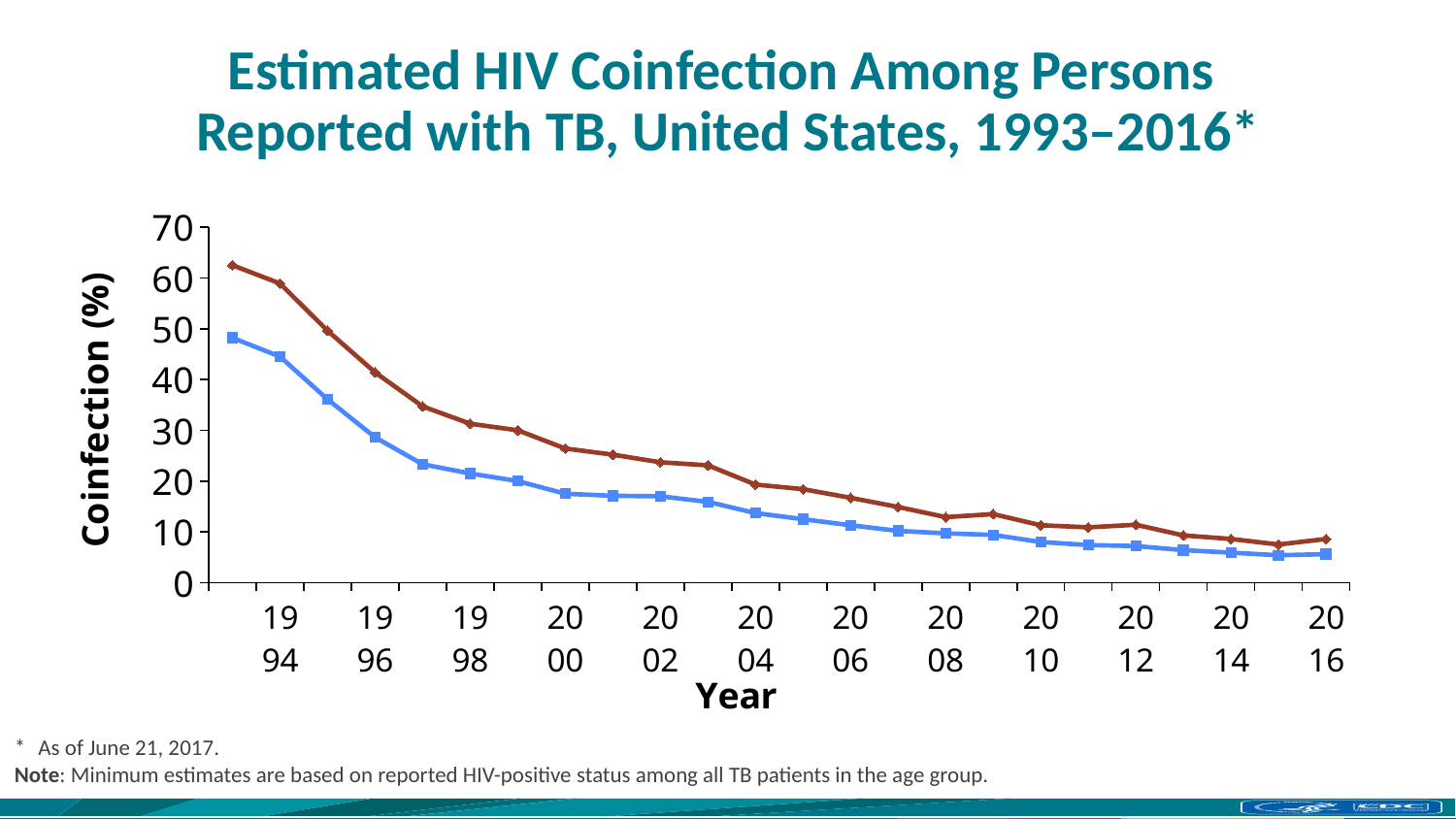
What kind of chart is shown on the slide? line chart Do the values on the chart rise or fall from 1994 to 2016? fall What is the label on the vertical axis of the chart? Coinfection (%) Does the red line reach its highest value at the start or at the end of the period shown? at the start Which line has the higher value in 2008, the red line or the blue line? the red line How many lines are plotted on the chart? 2 Is the value of the red line in 1994 greater or less than 50? greater Is the value of the blue line in 1994 greater or less than 50? less Is the value of the red line in 2000 greater or less than 20? greater What is the title of the chart? Estimated HIV Coinfection Among Persons Reported with TB, United States, 1993–2016*